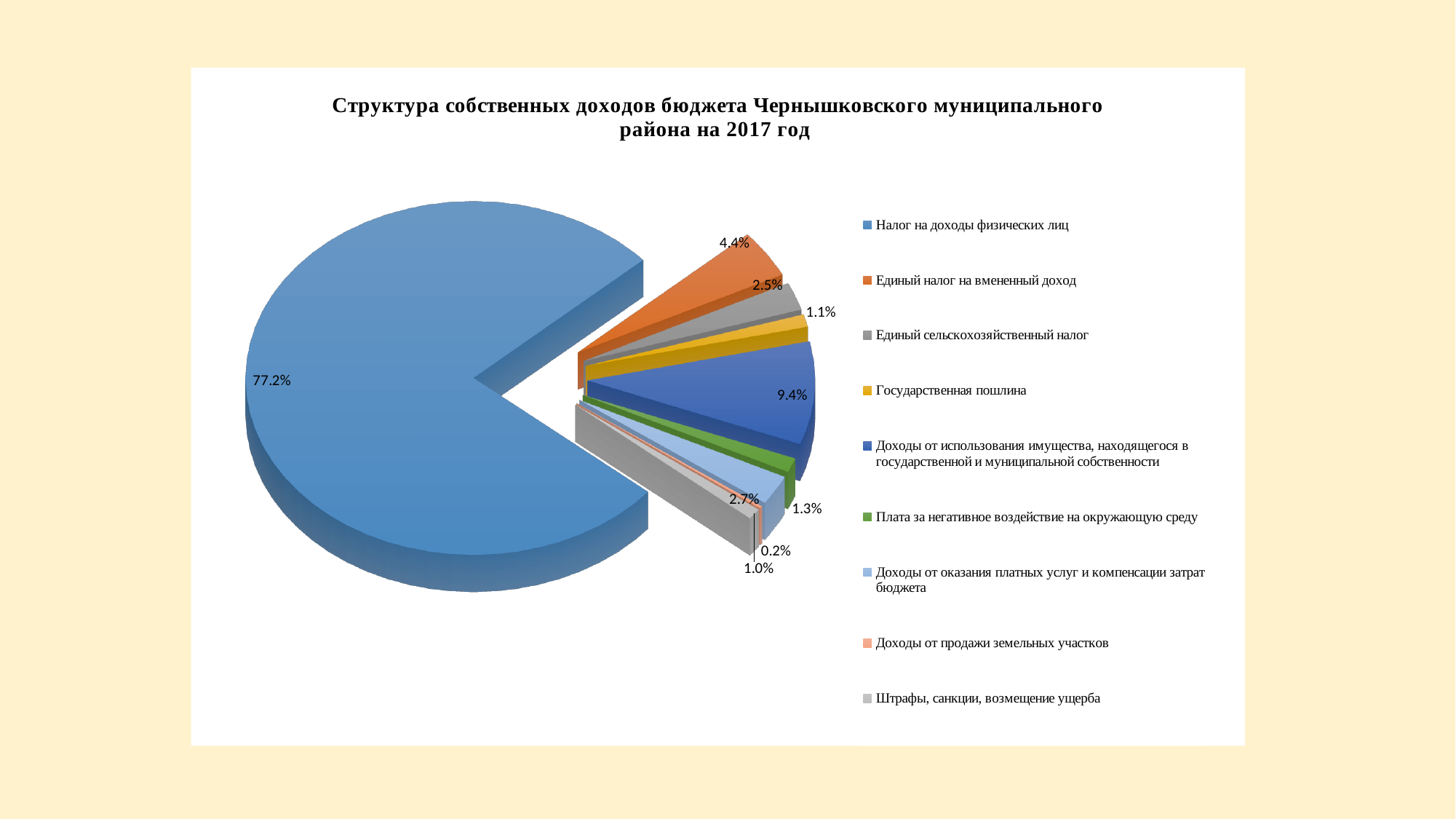
Which is larger: the value for "Единый сельскохозяйственный налог" or the value for "Доходы от оказания платных услуг и компенсации затрат бюджета"? Доходы от оказания платных услуг и компенсации затрат бюджета Which category has the smallest slice of the pie? Доходы от продажи земельных участков What is the value shown for "Единый налог на вмененный доход"? 4.4% What kind of chart is shown on the slide? Pie chart What is the title of the chart? Структура собственных доходов бюджета Чернышковского муниципального района на 2017 год What is the value shown for "Доходы от продажи земельных участков"? 0.2% What is the value shown for "Штрафы, санкции, возмещение ущерба"? 1.0% What is the value shown for "Доходы от использования имущества, находящегося в государственной и муниципальной собственности"? 9.4% What share of the pie does "Налог на доходы физических лиц" have? 77.2% How many categories does the legend list? 9 What is the difference between the values for "Доходы от использования имущества, находящегося в государственной и муниципальной собственности" and "Единый налог на вмененный доход"? 5.0% Which category has the largest slice of the pie? Налог на доходы физических лиц